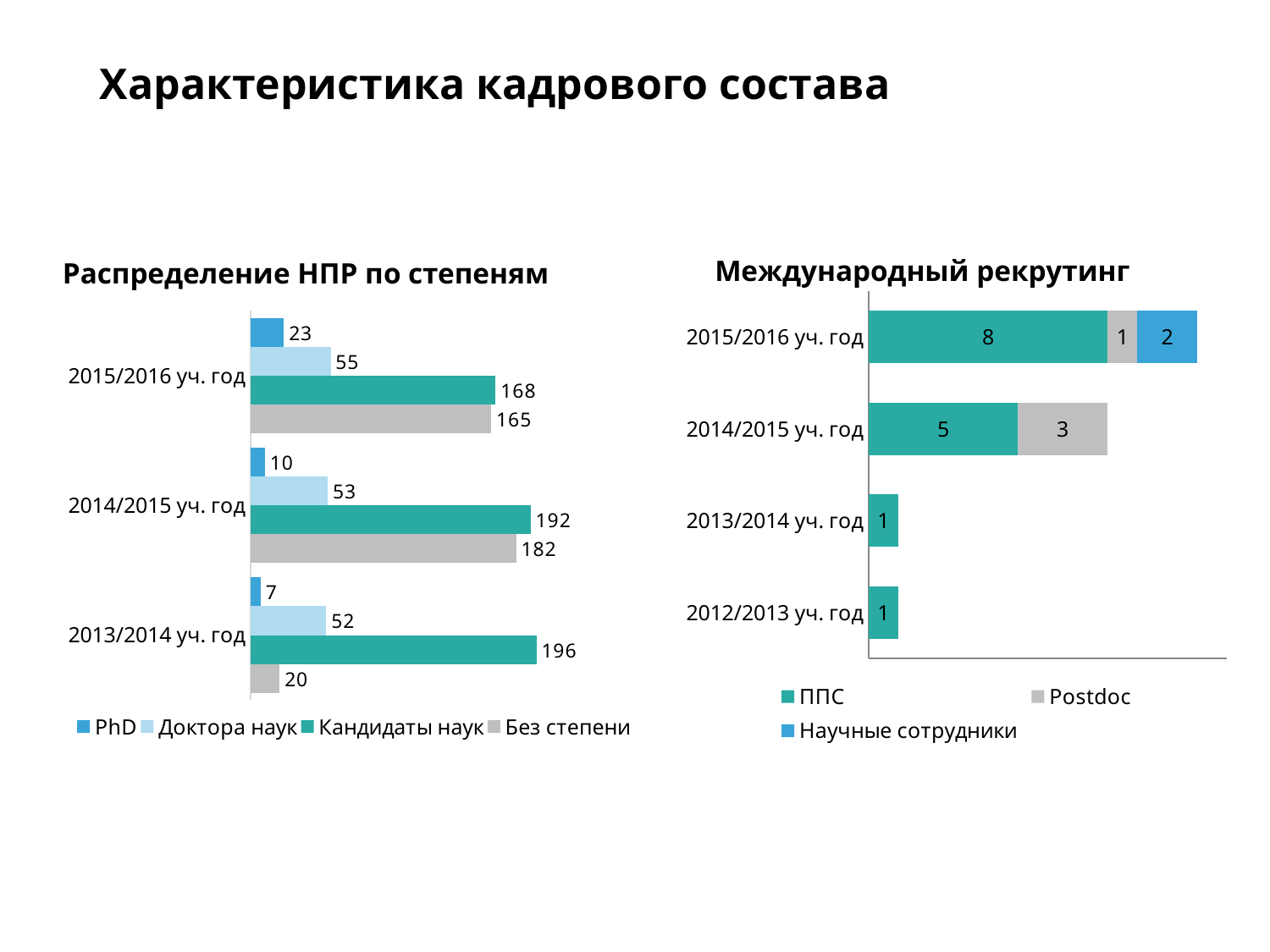
In the chart 'Международный рекрутинг', what is the total of the stacked bar for 2015/2016 уч. год? 11 In the chart 'Распределение НПР по степеням', how does the PhD value change from 2013/2014 to 2015/2016? It rises What type of chart is 'Международный рекрутинг'? Stacked bar chart In the chart 'Распределение НПР по степеням', which year has the highest PhD value? 2015/2016 уч. год In the chart 'Распределение НПР по степеням', what is the value for Кандидаты наук in 2013/2014 уч. год? 196 In the chart 'Распределение НПР по степеням', what is the value for PhD in 2015/2016 уч. год? 23 In the chart 'Международный рекрутинг', what is the value for ППС in 2015/2016 уч. год? 8 In the chart 'Международный рекрутинг', what is the total of the stacked bar for 2014/2015 уч. год? 8 In the chart 'Распределение НПР по степеням', which is larger in 2014/2015 уч. год: Доктора наук or PhD? Доктора наук In the chart 'Распределение НПР по степеням', what is the difference between Кандидаты наук and Без степени in 2015/2016 уч. год? 3 In the chart 'Распределение НПР по степеням', what is the value for Без степени in 2014/2015 уч. год? 182 In the chart 'Распределение НПР по степеням', how many series does the legend list? 4